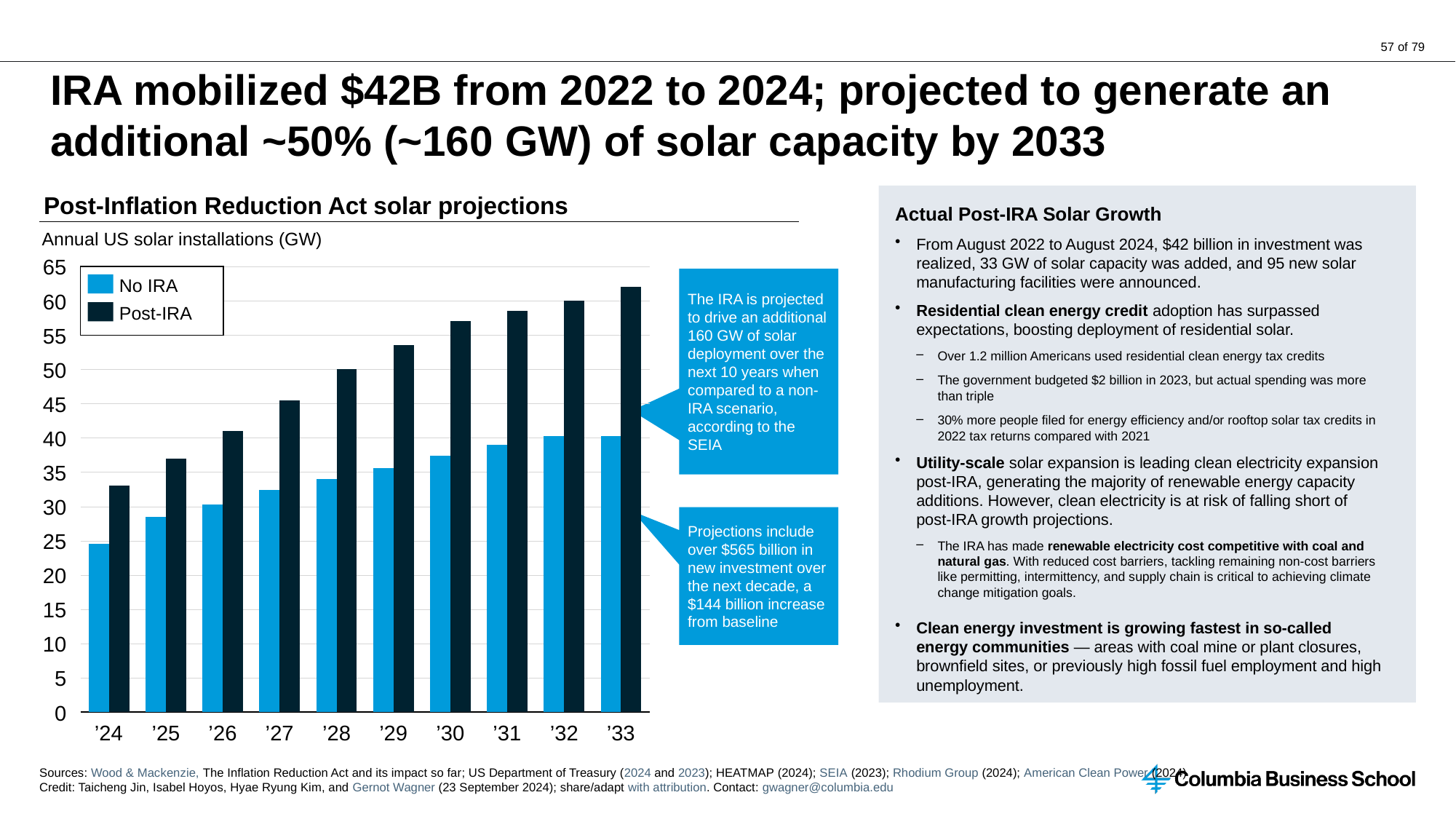
What kind of chart is shown under 'Post-Inflation Reduction Act solar projections'? Bar chart Is the Post-IRA value for '24 greater or less than 30? greater How many years are shown on the x axis of the solar projections chart? 10 Is the No IRA value for '33 greater or less than 45? less In which year is the No IRA bar lowest in the solar projections chart? '24 For '30, which series has the larger value, No IRA or Post-IRA? Post-IRA What unit is given for the y axis of the solar projections chart? GW Do the Post-IRA values rise or fall from '24 to '33? Rise Which is larger: the No IRA value for '33 or the Post-IRA value for '24? No IRA value for '33 Is the Post-IRA value for '28 greater or less than 45? greater In which year is the Post-IRA bar highest in the solar projections chart? '33 How many series does the legend of the solar projections chart list? 2